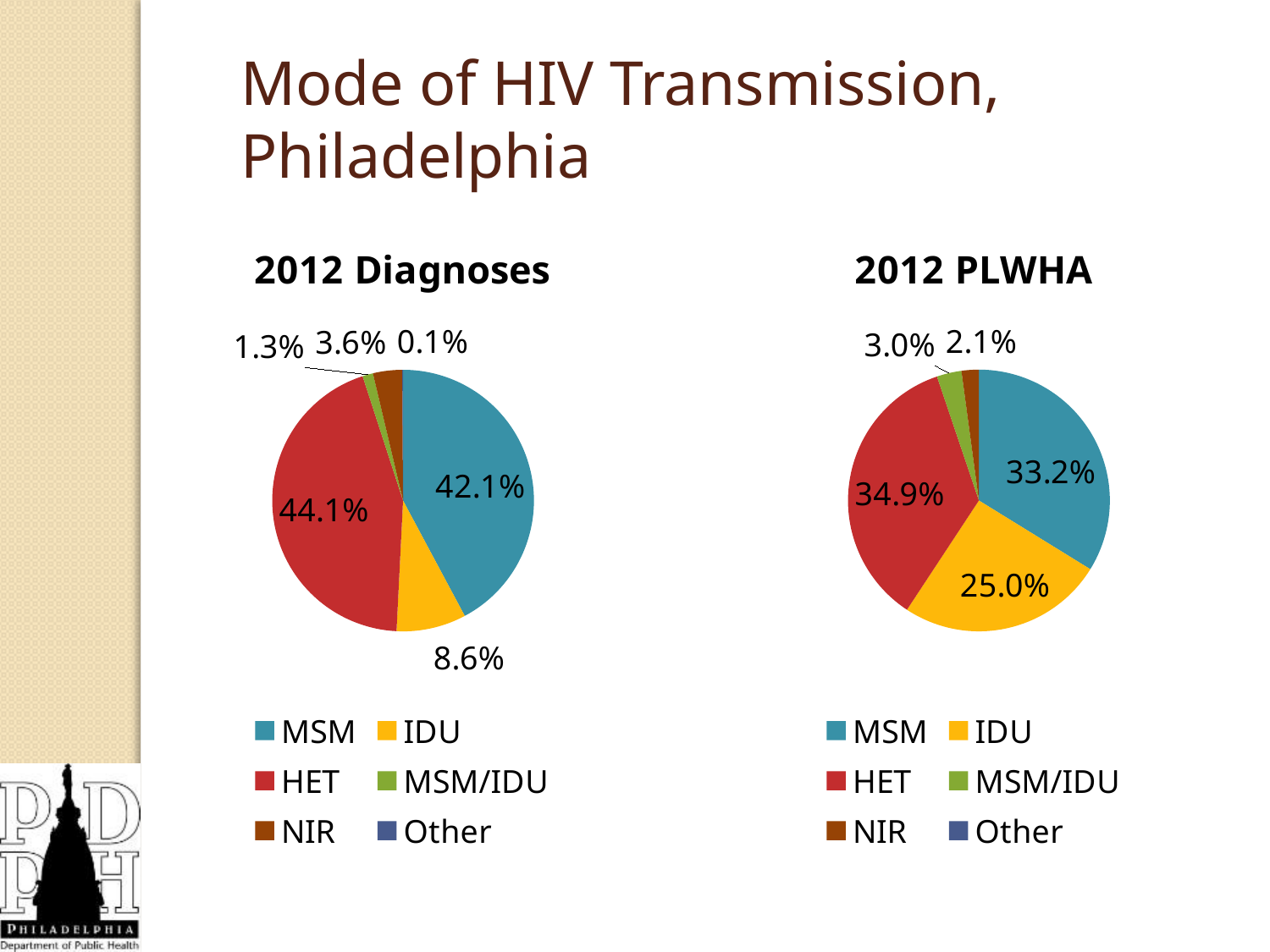
In the 2012 PLWHA chart, what is the difference between the HET and MSM shares? 1.7% In the 2012 PLWHA chart, what share of the pie is IDU? 25.0% In the 2012 Diagnoses chart, what share of the pie is MSM? 42.1% How many categories does the legend of the 2012 Diagnoses chart list? 6 In the 2012 PLWHA chart, what share of the pie is MSM/IDU? 3.0% In the 2012 PLWHA chart, what share of the pie is HET? 34.9% In the 2012 Diagnoses chart, which category has the smallest slice? Other In the 2012 Diagnoses chart, what share of the pie is HET? 44.1% In the 2012 Diagnoses chart, which is larger, the IDU slice or the NIR slice? IDU What kind of chart is used for 2012 PLWHA? Pie chart In the 2012 Diagnoses chart, what share of the pie is IDU? 8.6% In the 2012 Diagnoses chart, which category has the largest slice? HET